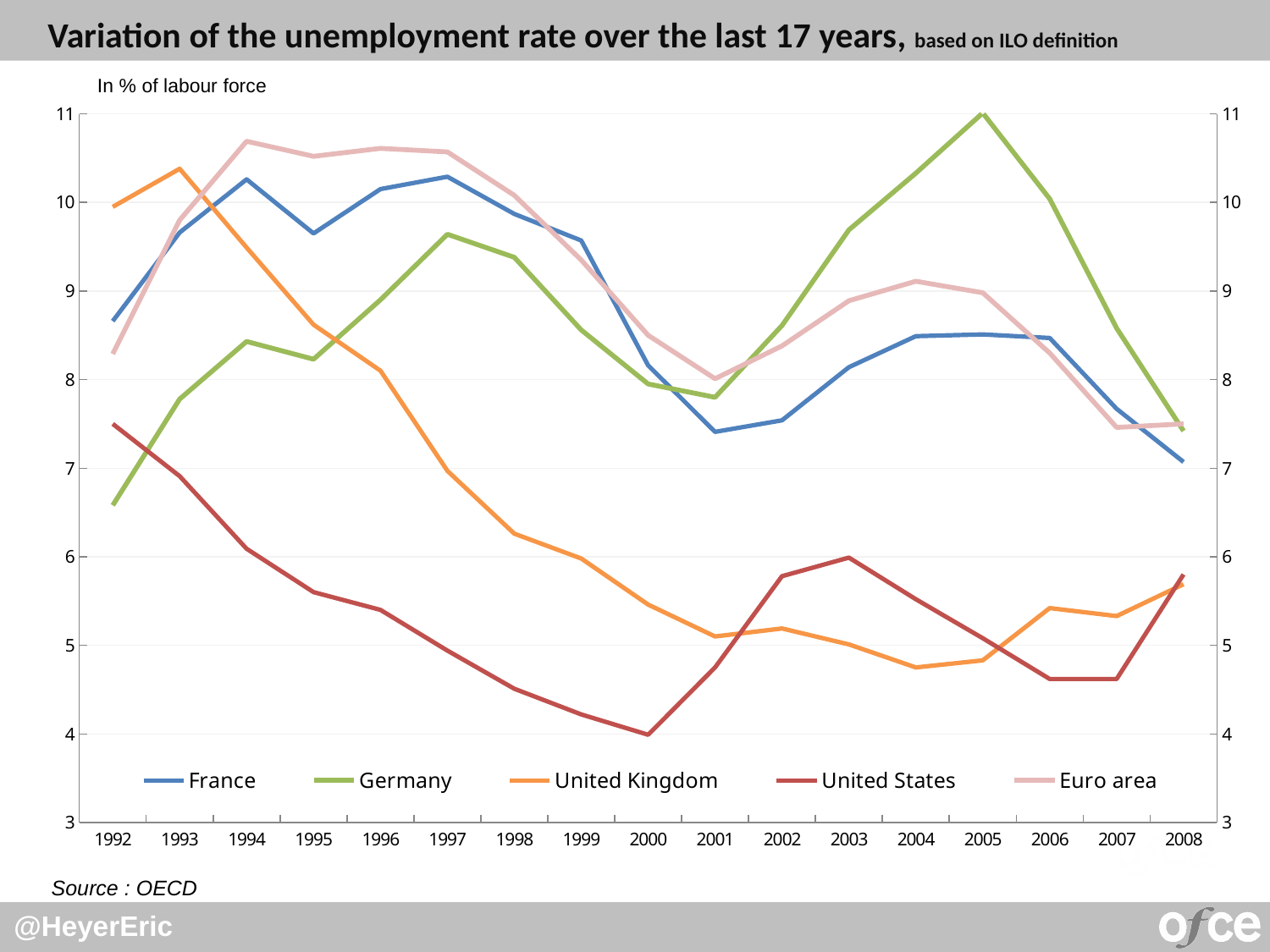
What kind of chart is shown on the slide? line chart Does the unemployment rate for Germany rise or fall from 2005 to 2008? fall Which series has the highest unemployment rate in 2005? Germany Is the value for the United Kingdom in 2004 greater or less than 5? less Is the value for the United States in 2003 greater or less than 5? greater In 2008, which is larger: the unemployment rate for France or for the United Kingdom? France Which series has the lowest unemployment rate in 1992? Germany How many years are shown on the x axis? 17 What is the source cited below the chart? OECD Which series has the lowest unemployment rate in 2006? United States Which series has the highest unemployment rate in 1994? Euro area How many series does the legend list? 5